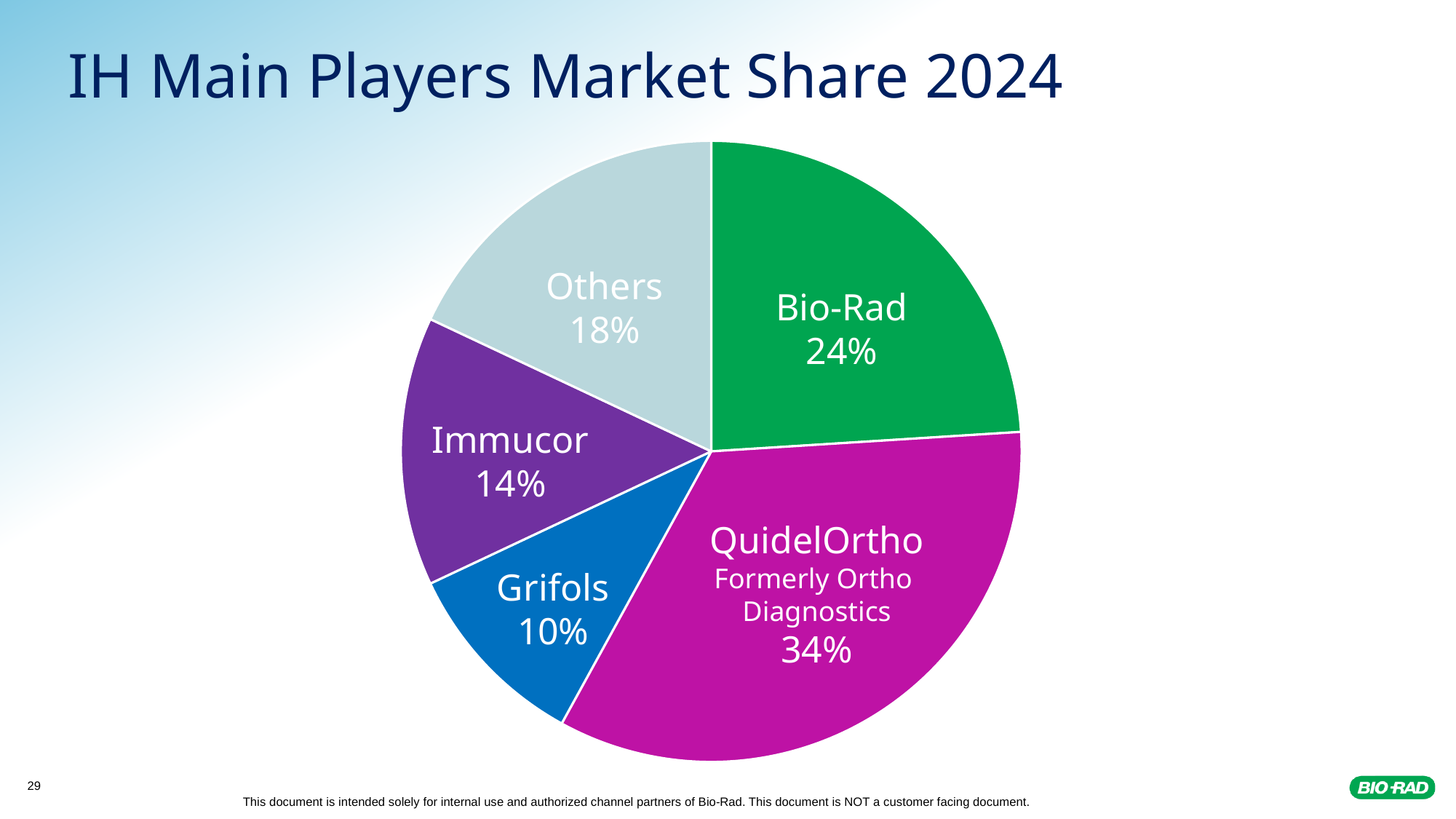
Which player has the largest market share? QuidelOrtho What is the market share of Immucor? 14% Which has a larger market share, Immucor or Others? Others What is the market share of QuidelOrtho? 34% What colour is the Bio-Rad slice? Green What is the difference in market share between QuidelOrtho and Bio-Rad? 10% What is the market share of Bio-Rad? 24% What is the title of the slide? IH Main Players Market Share 2024 What kind of chart is shown on the slide? Pie chart Which player has the smallest market share? Grifols How many slices does the pie chart have? 5 What is the market share of Grifols? 10%